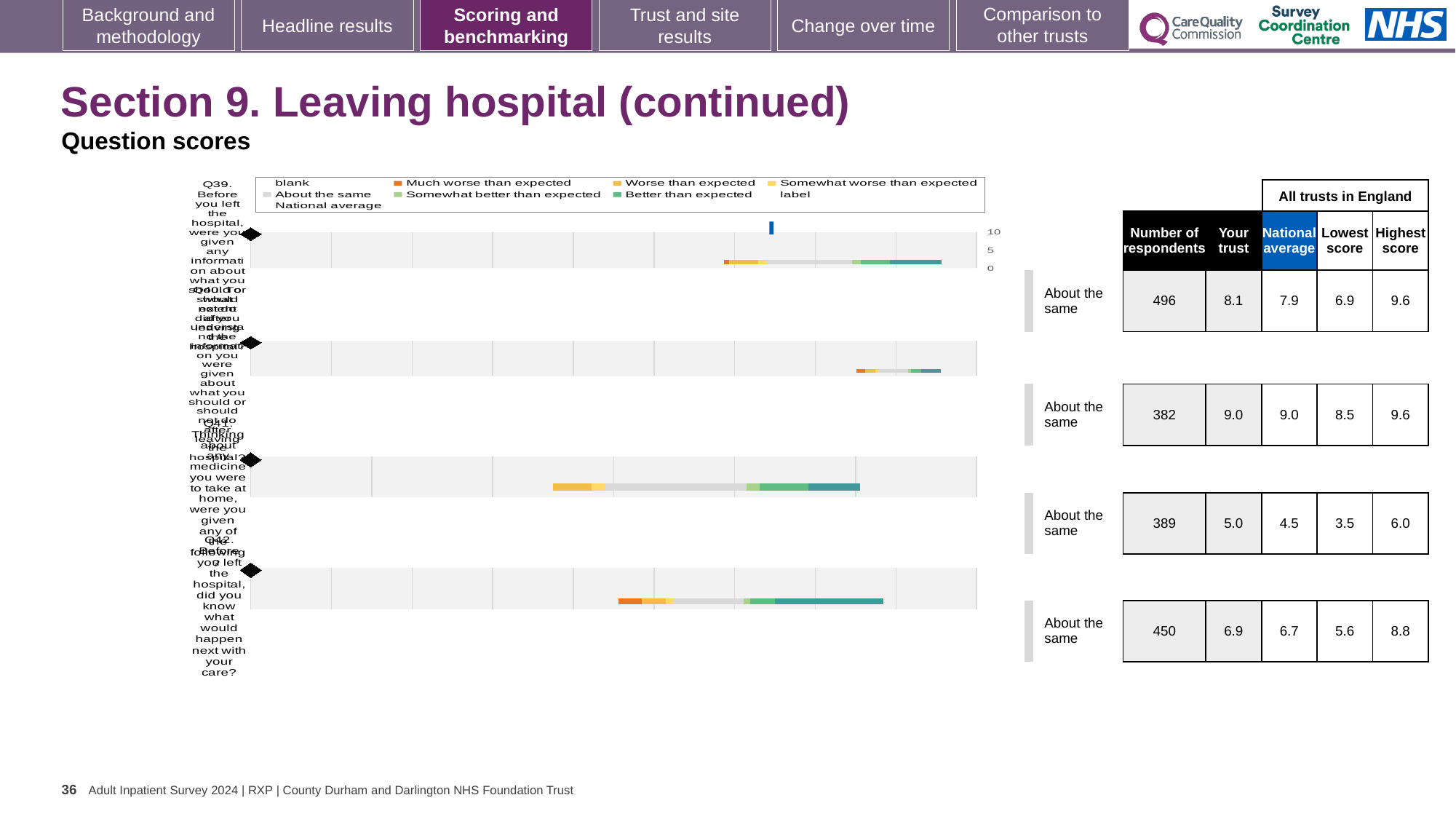
Which question has the lowest 'Your trust' score in the table beside the chart? Q41 For Q39, what is the difference between the 'Your trust' score and the national average in the table? 0.2 What benchmark category is shown for every question on this slide? About the same What kind of chart is used to show the question scores on this slide? bar chart Which question has the highest 'Your trust' score in the table beside the chart? Q40 How many questions (bars) are plotted in the chart? 4 In the table beside the chart, what is the highest score across all trusts in England for Q42? 8.8 In the table beside the chart, what is the 'Your trust' score for Q39 (Before you left the hospital, were you given any information about what you should or should not do after leaving hospital)? 8.1 In the table beside the chart, what is the national average for Q39? 7.9 What is the first question label shown at the top of the chart? Q39 In the table beside the chart, how many respondents answered Q42 (Before you left the hospital, did you know what would happen next with your care)? 450 For Q42, which is larger: the 'Your trust' score or the national average? Your trust